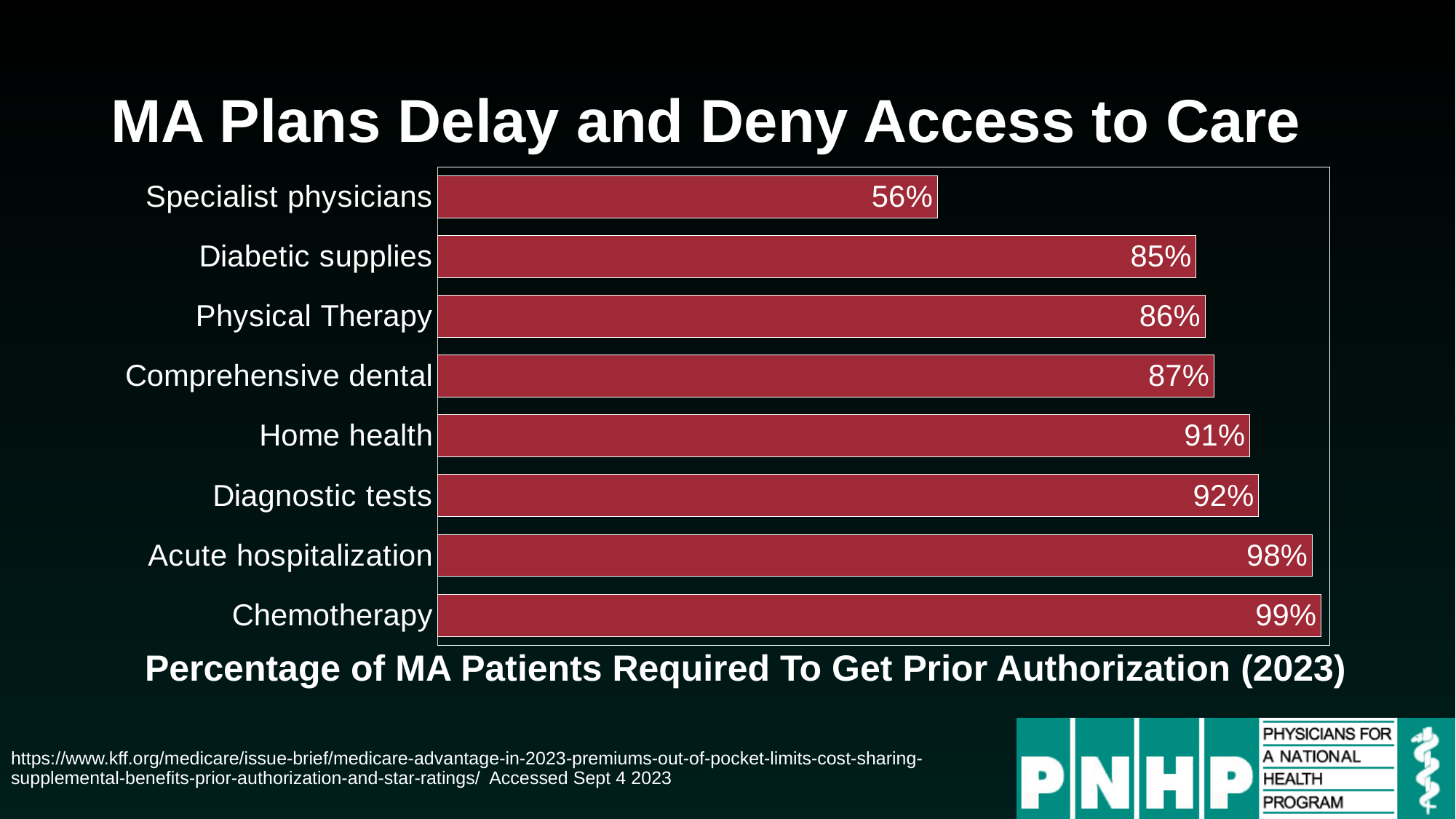
What is the caption below the chart? Percentage of MA Patients Required To Get Prior Authorization (2023) Which is larger, the value for Diabetic supplies or the value for Diagnostic tests? Diagnostic tests What is the difference between the values for Acute hospitalization and Diagnostic tests? 6% What is the value shown for Comprehensive dental? 87% What kind of chart is shown on the slide? Bar chart What percentage of MA patients were required to get prior authorization for Chemotherapy? 99% What is the difference between the values for Chemotherapy and Specialist physicians? 43% What is the value shown for Home health? 91% Which category has the highest percentage requiring prior authorization? Chemotherapy How many categories are shown in the chart? 8 What percentage of MA patients were required to get prior authorization for Specialist physicians? 56% Which category has the lowest percentage requiring prior authorization? Specialist physicians